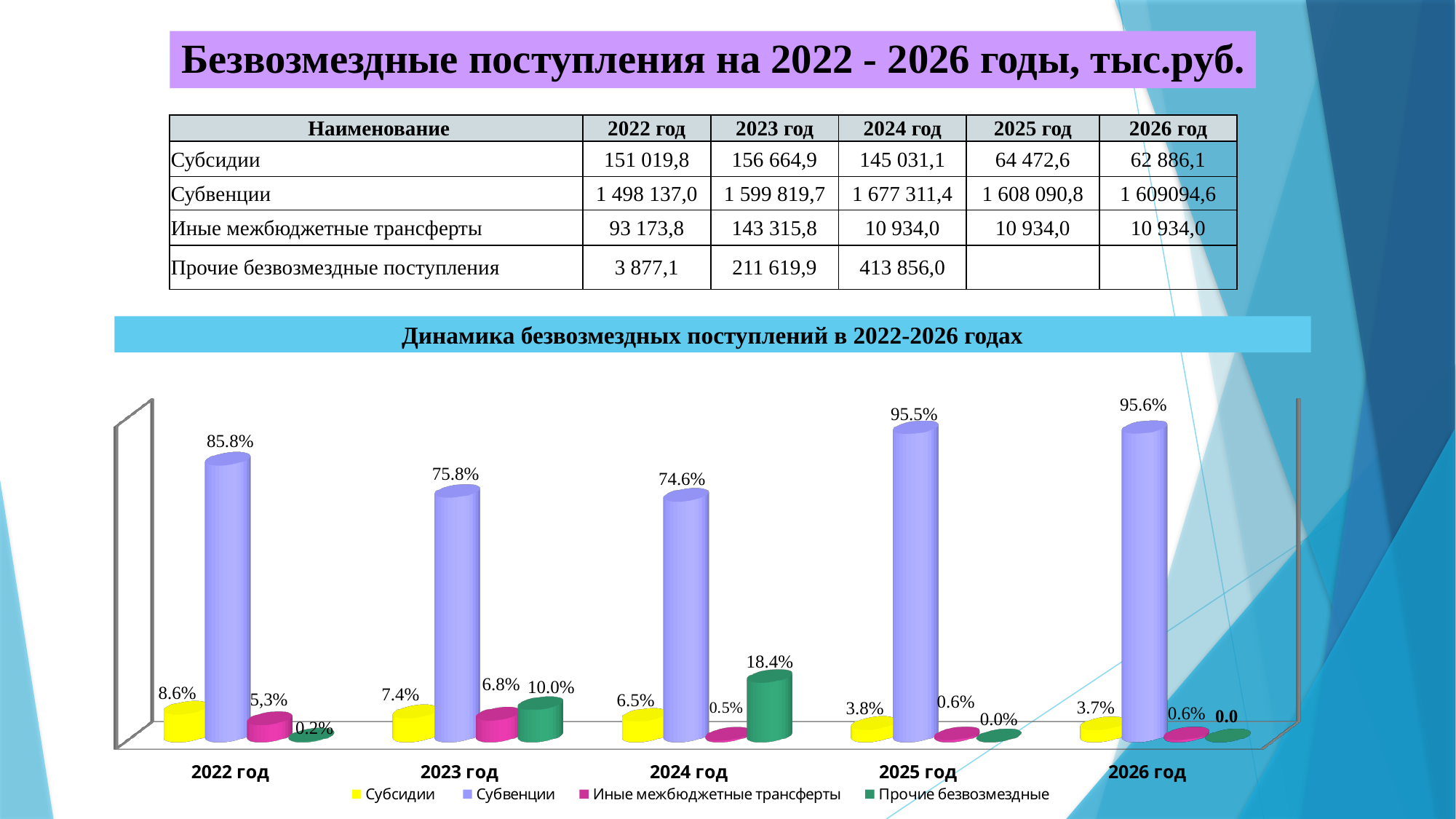
What is the value for Субсидии in 2026 год? 3.7% How many years are shown on the x axis of the chart? 5 What kind of chart is shown on the slide? Bar chart Does the Субсидии value rise or fall from 2022 год to 2026 год? Fall In which year is the Субсидии value lowest? 2026 год Which is larger in 2023 год: Субсидии or Прочие безвозмездные? Прочие безвозмездные What is the value for Прочие безвозмездные in 2024 год? 18.4% What is the value for Иные межбюджетные трансферты in 2023 год? 6.8% What is the value for Субвенции in 2022 год? 85.8% What is the difference between the Субвенции values for 2025 год and 2024 год? 20.9% In which year is the Субвенции value highest? 2026 год How many series does the chart legend list? 4